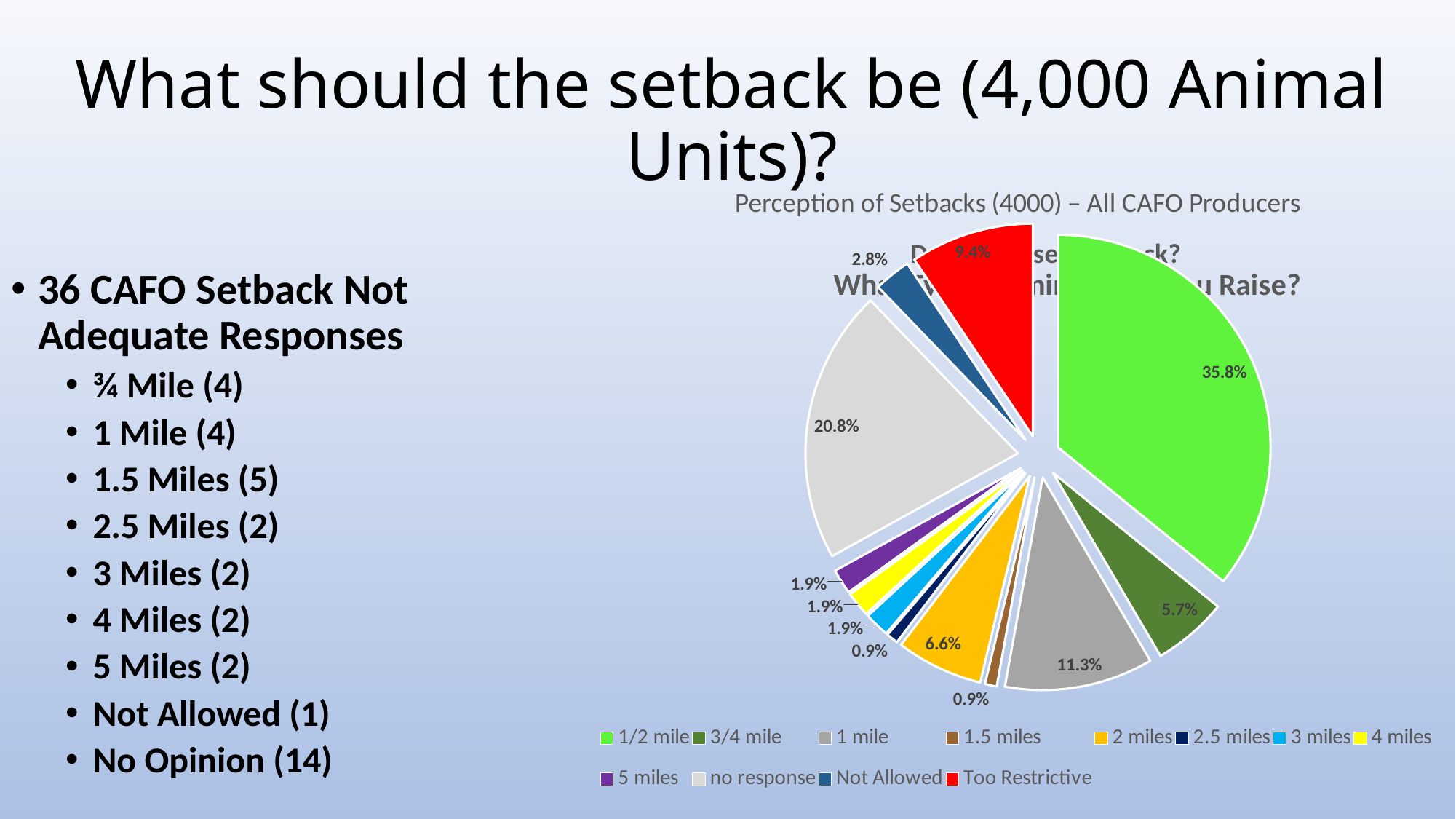
What is the value shown for the 2 miles slice? 6.6% What is the smallest percentage shown on any slice of the pie? 0.9% Which is larger, the 3/4 mile slice or the Too Restrictive slice? Too Restrictive What is the title of the chart? Perception of Setbacks (4000) – All CAFO Producers What type of chart is shown on the slide? pie chart What share of the pie does the 1/2 mile slice represent? 35.8% How many categories does the legend list? 12 What is the difference between the 1/2 mile slice and the no response slice? 15.0% What is the value shown for the Too Restrictive slice? 9.4% What is the value shown for the 1 mile slice? 11.3% What is the value shown for the no response slice? 20.8% Which category has the largest slice of the pie? 1/2 mile